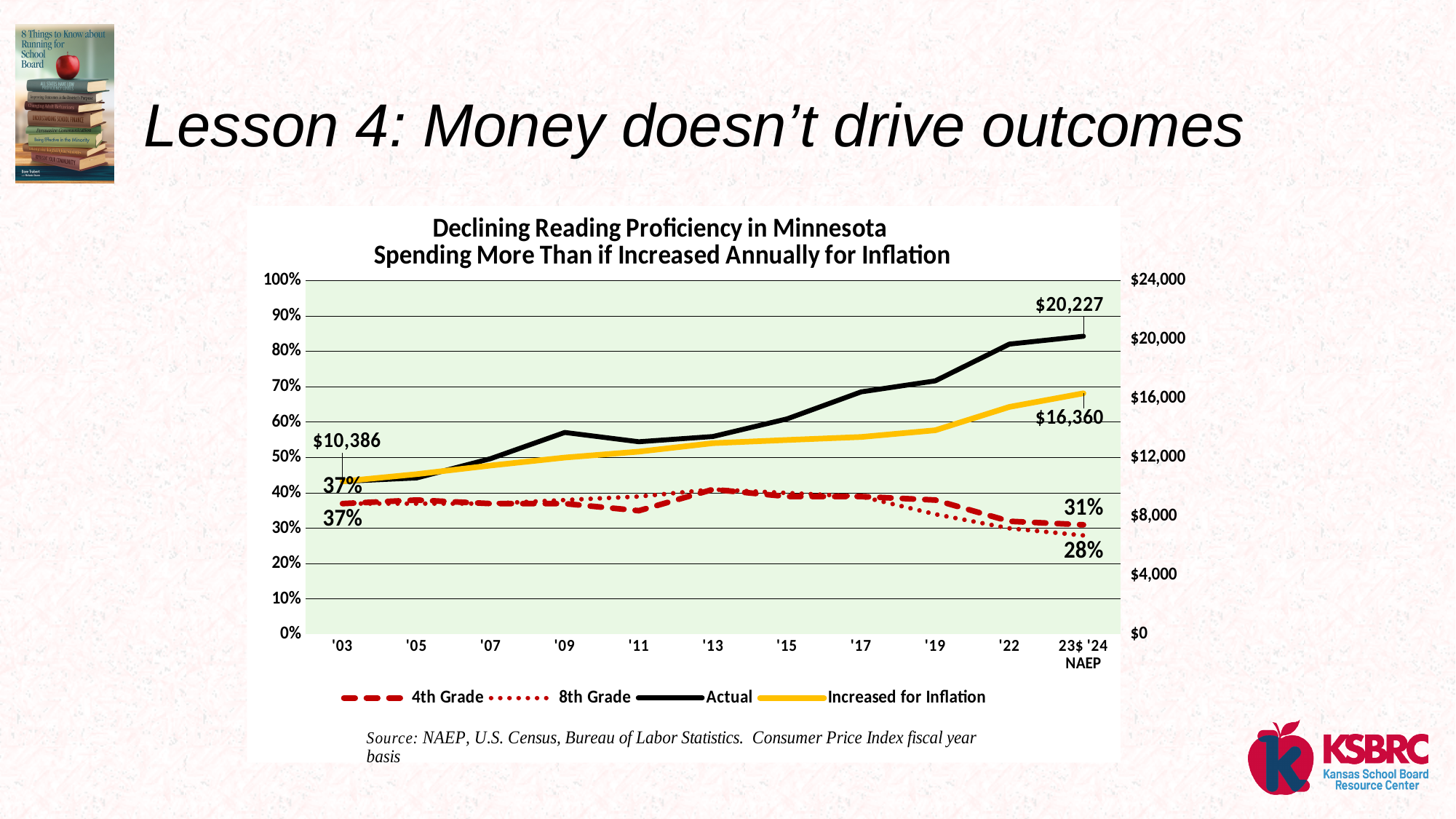
What is the first line of the chart's title? Declining Reading Proficiency in Minnesota What kind of chart is shown on the slide? line chart How many series does the chart's legend list? 4 What is the labelled spending value at '03? $10,386 By how many percentage points did 4th Grade reading proficiency change from its labelled '03 value to its labelled final value? 6% What is the difference between the Actual spending and the Increased for Inflation spending at the right end of the chart? $3,867 What is the labelled value of the Increased for Inflation series at the right end of the chart? $16,360 Does the 4th Grade reading proficiency line rise or fall from '03 to the end of the chart? fall At the right end of the chart, which is larger: Actual spending or Increased for Inflation spending? Actual What is the labelled value of the Actual spending series at the right end of the chart? $20,227 What is the labelled 8th Grade reading proficiency at the right end of the chart? 28% What is the labelled 4th Grade reading proficiency at the right end of the chart? 31%